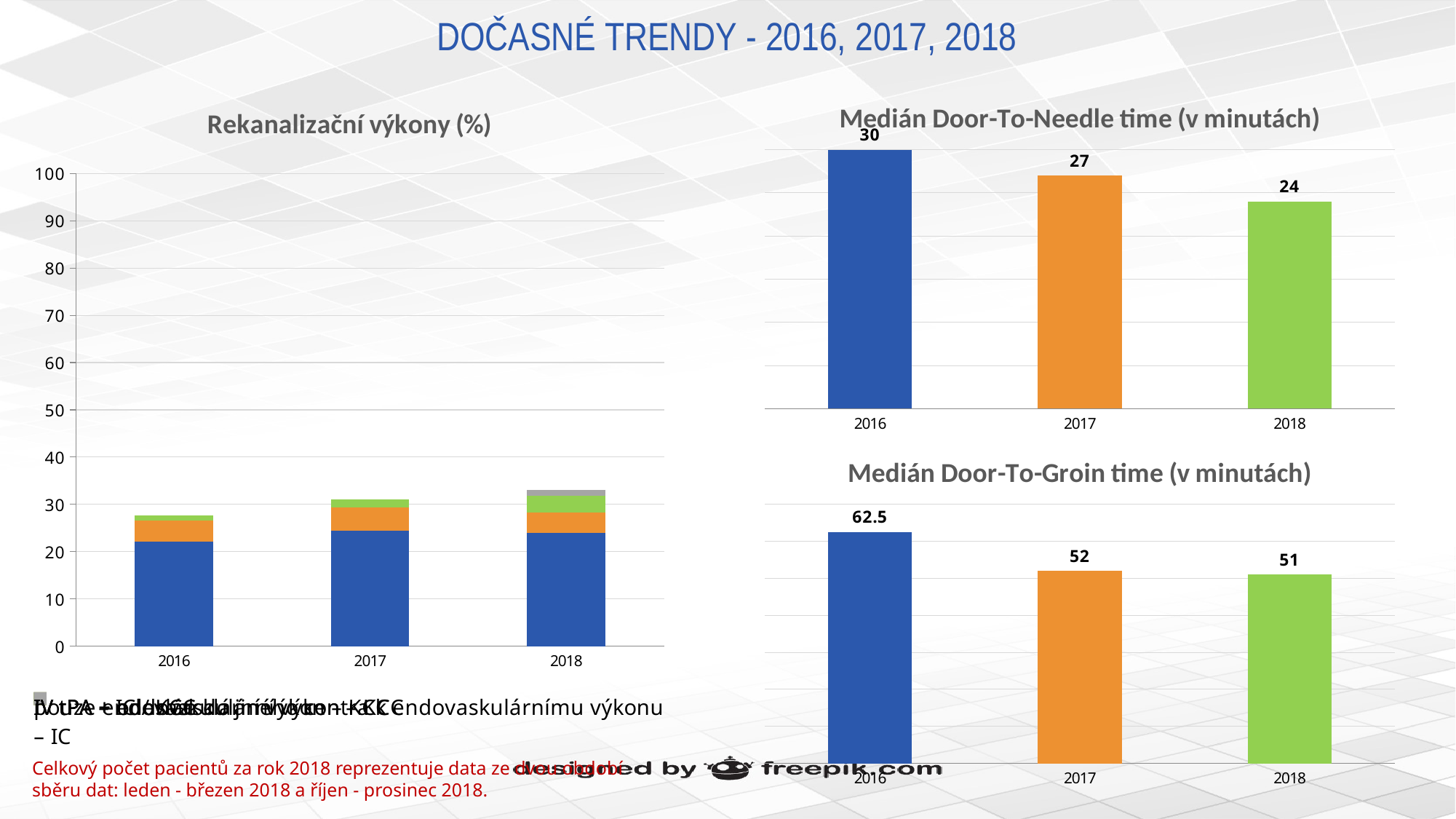
In the 'Rekanalizační výkony (%)' chart, is the total stacked value for 2018 greater or less than 40? less What kind of chart is the 'Medián Door-To-Groin time (v minutách)' chart? bar chart In the 'Medián Door-To-Groin time (v minutách)' chart, what is the value for 2017? 52 In the 'Medián Door-To-Groin time (v minutách)' chart, which year has the highest value? 2016 In the 'Medián Door-To-Needle time (v minutách)' chart, which year has the lowest value? 2018 In the 'Medián Door-To-Groin time (v minutách)' chart, what is the value for 2016? 62.5 In the 'Medián Door-To-Needle time (v minutách)' chart, do the values rise or fall from 2016 to 2018? fall In the 'Medián Door-To-Needle time (v minutách)' chart, what is the difference between the 2016 and 2018 values? 6 In the 'Medián Door-To-Needle time (v minutách)' chart, what is the value for 2018? 24 How many years are shown on the x axis of the 'Rekanalizační výkony (%)' chart? 3 In the 'Medián Door-To-Groin time (v minutách)' chart, what is the difference between the 2016 and 2017 values? 10.5 In the 'Medián Door-To-Needle time (v minutách)' chart, what is the value for 2016? 30